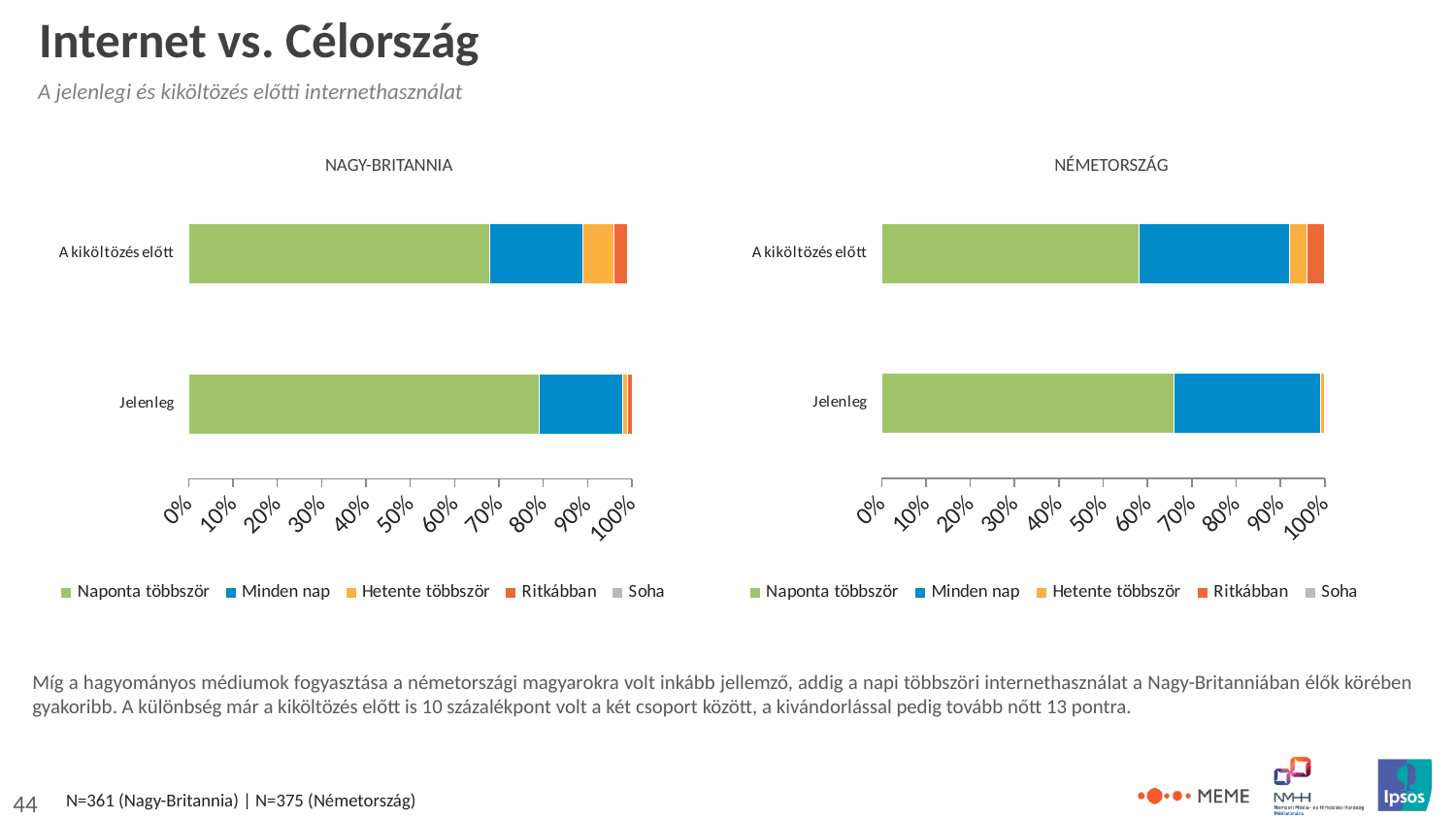
In the NÉMETORSZÁG chart, which category has the larger 'Naponta többször' share: 'A kiköltözés előtt' or 'Jelenleg'? Jelenleg In the NAGY-BRITANNIA chart, is the 'Naponta többször' value for 'Jelenleg' greater or less than 70%? greater In the NÉMETORSZÁG chart, is the 'Naponta többször' value for 'Jelenleg' greater or less than 60%? greater In the NAGY-BRITANNIA chart, is the 'Naponta többször' value for 'A kiköltözés előtt' greater or less than 60%? greater In the NAGY-BRITANNIA chart, which category has the larger 'Naponta többször' share: 'A kiköltözés előtt' or 'Jelenleg'? Jelenleg How many series does the legend of the NÉMETORSZÁG chart list? 5 What is the title of the chart on the right side of the slide? NÉMETORSZÁG How many categories are shown on the NAGY-BRITANNIA chart? 2 In the NÉMETORSZÁG chart, which category has the larger 'Hetente többször' share: 'A kiköltözés előtt' or 'Jelenleg'? A kiköltözés előtt Which legend entry is shown in green in the NAGY-BRITANNIA chart? Naponta többször What kind of chart is the NAGY-BRITANNIA chart? Stacked bar chart